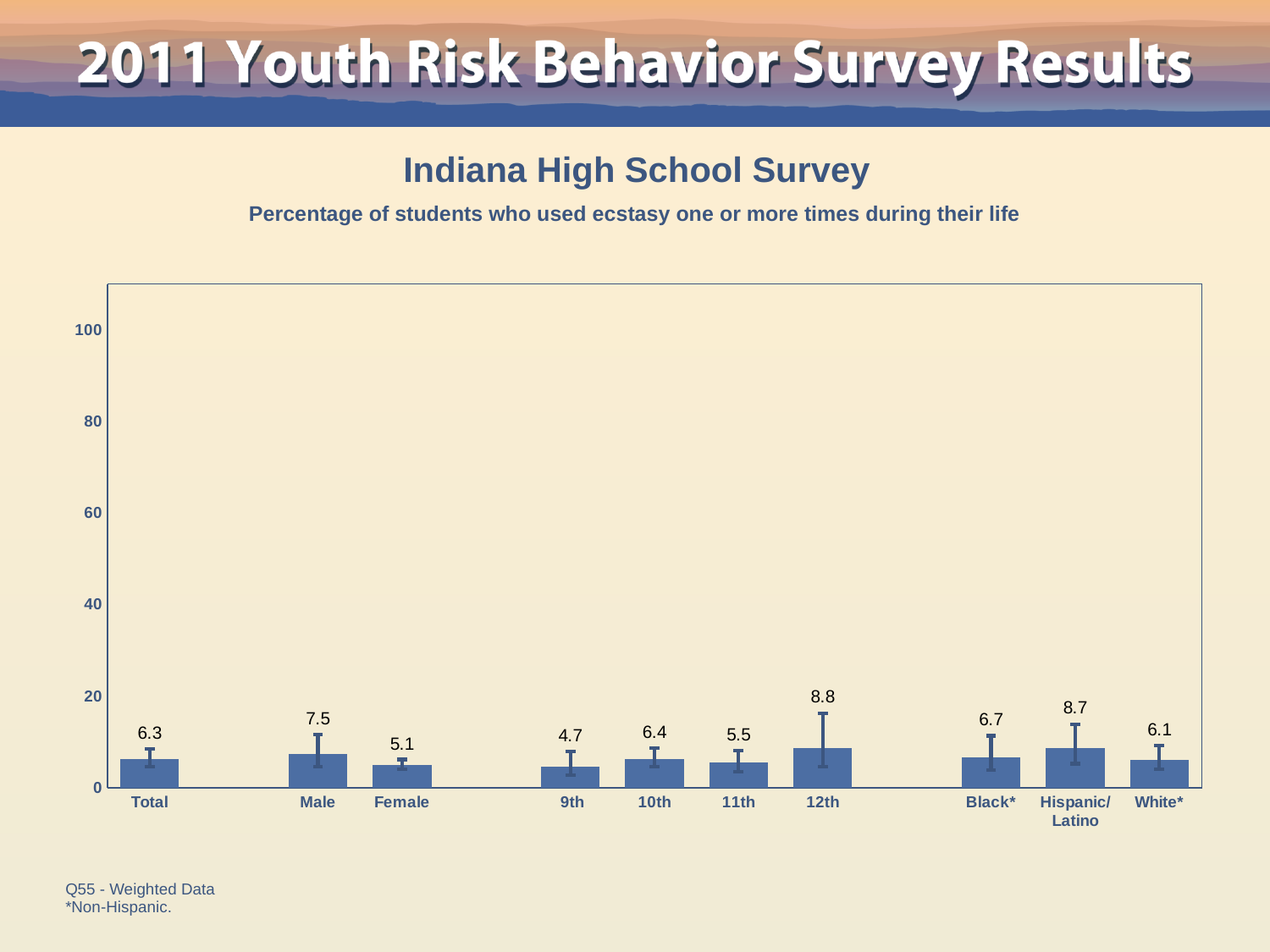
What is the value for Total? 6.3 What kind of chart is shown on the slide? bar chart Which is larger, the value for Black* or the value for White*? Black* What is the value for 12th? 8.8 Which category has the highest value? 12th What is the value for Hispanic/Latino? 8.7 How many categories are shown on the x axis? 10 Is the value for 12th greater or less than 20? less What is the value for Male? 7.5 What is the difference between the values for Male and Female? 2.4 Which category has the lowest value? 9th What is the subtitle describing what the chart measures? Percentage of students who used ecstasy one or more times during their life